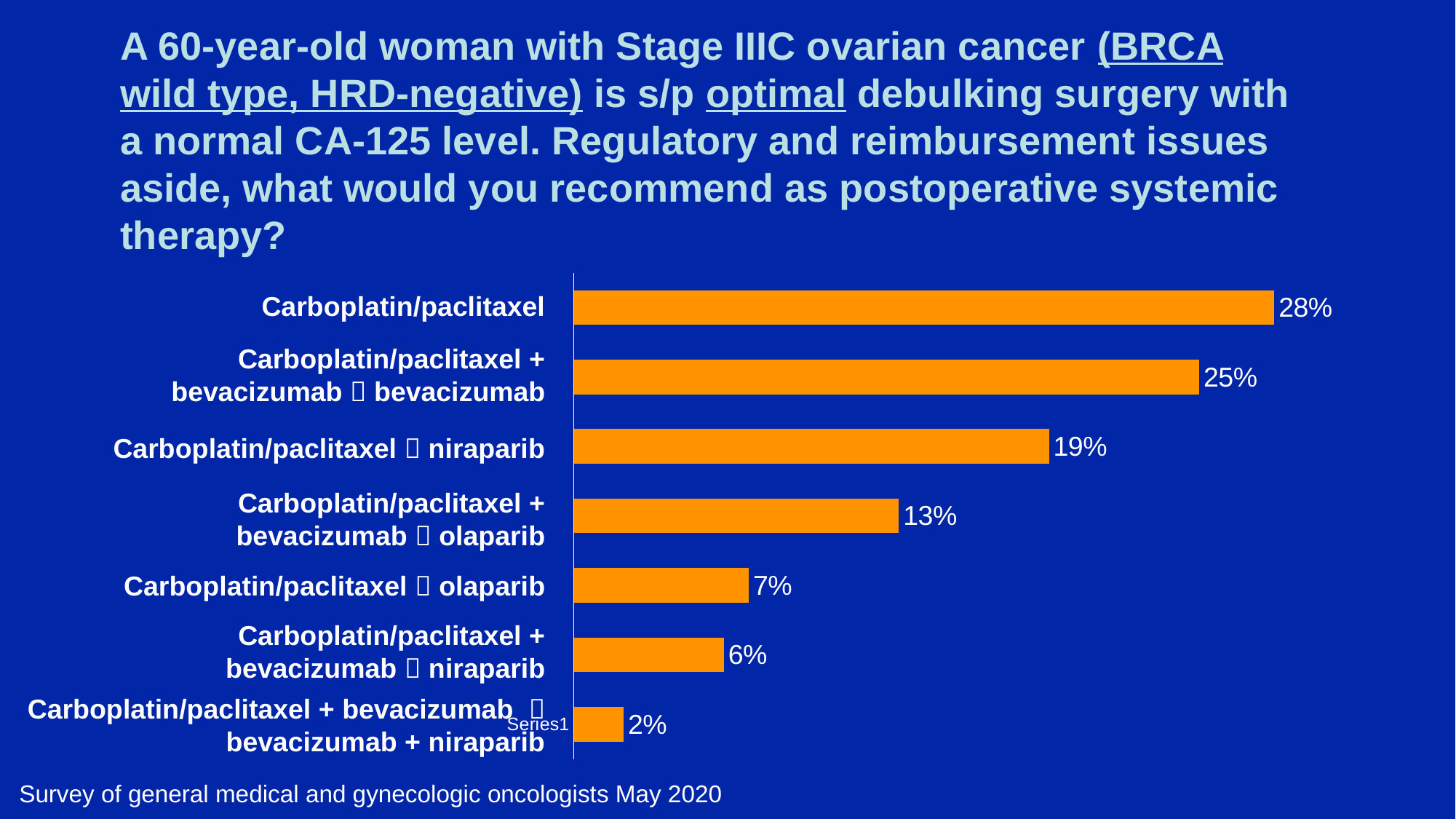
Which treatment option received the highest percentage of recommendations? Carboplatin/paclitaxel Which received a higher percentage: Carboplatin/paclitaxel → olaparib or Carboplatin/paclitaxel + bevacizumab → niraparib? Carboplatin/paclitaxel → olaparib Which treatment option received the lowest percentage of recommendations? Carboplatin/paclitaxel + bevacizumab → bevacizumab + niraparib What percentage of respondents recommended Carboplatin/paclitaxel → niraparib? 19% What percentage of respondents recommended Carboplatin/paclitaxel + bevacizumab → olaparib? 13% What colour are the bars in the chart? Orange What is the difference in percentage points between Carboplatin/paclitaxel and Carboplatin/paclitaxel + bevacizumab → bevacizumab? 3 percentage points What type of chart is shown on the slide? Bar chart What is the difference in percentage points between Carboplatin/paclitaxel → niraparib and Carboplatin/paclitaxel → olaparib? 12 percentage points How many treatment options are shown in the chart? 7 What percentage of respondents recommended Carboplatin/paclitaxel + bevacizumab → bevacizumab + niraparib? 2% What percentage of respondents recommended Carboplatin/paclitaxel alone? 28%